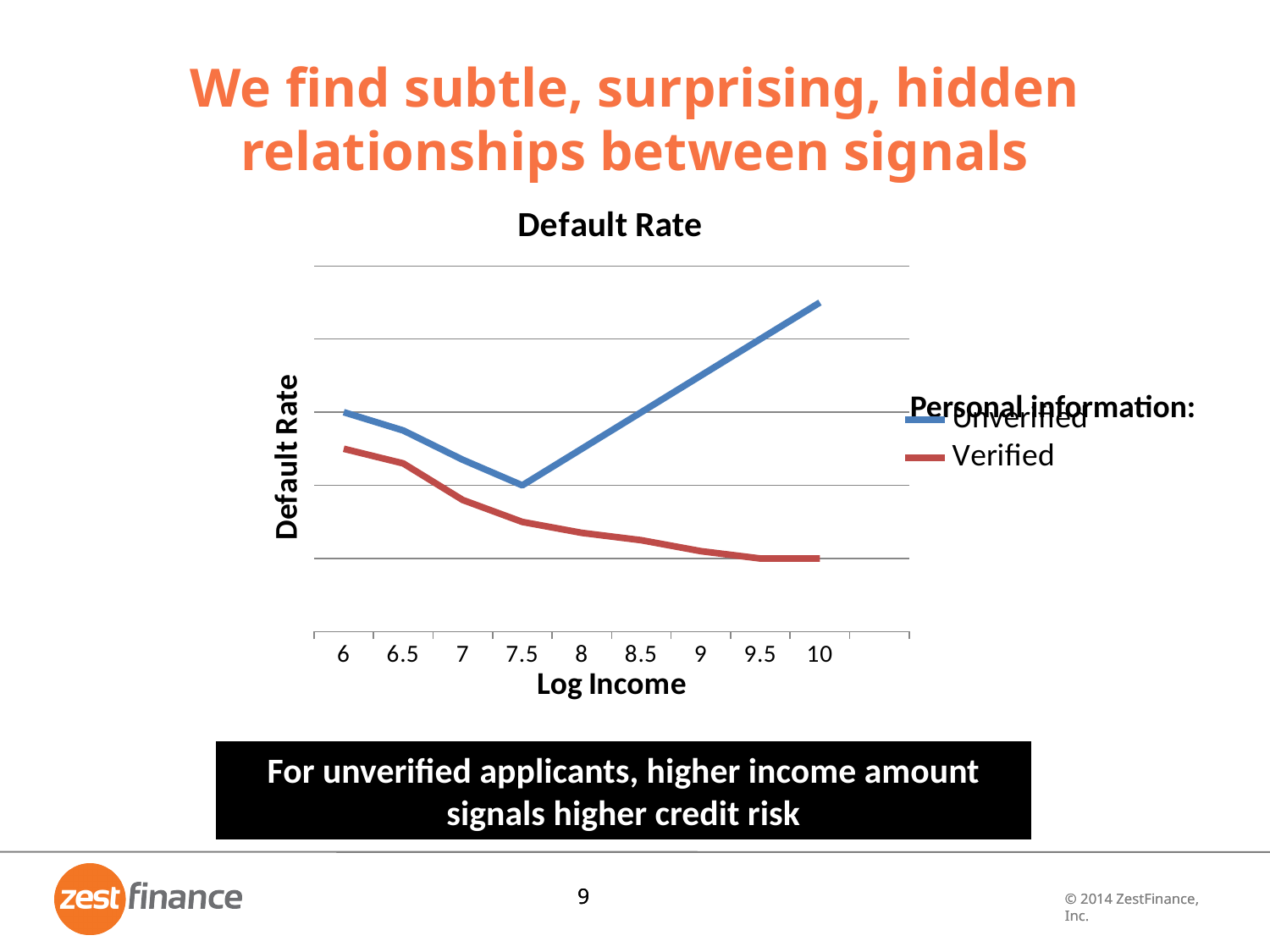
What kind of chart is shown on the slide? line chart Does the Unverified series rise or fall between Log Income 7.5 and 10? rise Does the Verified series rise or fall as Log Income increases? fall What is the title of the chart? Default Rate How many series does the legend list? 2 At which Log Income value does the Unverified series reach its highest default rate? 10 At Log Income 10, which series has the higher default rate, Unverified or Verified? Unverified How many Log Income values are marked along the x axis? 9 What is the label of the x axis? Log Income At Log Income 6, which series has the higher default rate, Unverified or Verified? Unverified Does the Unverified series rise or fall between Log Income 6 and 7.5? fall At which Log Income value does the Unverified series reach its lowest default rate? 7.5